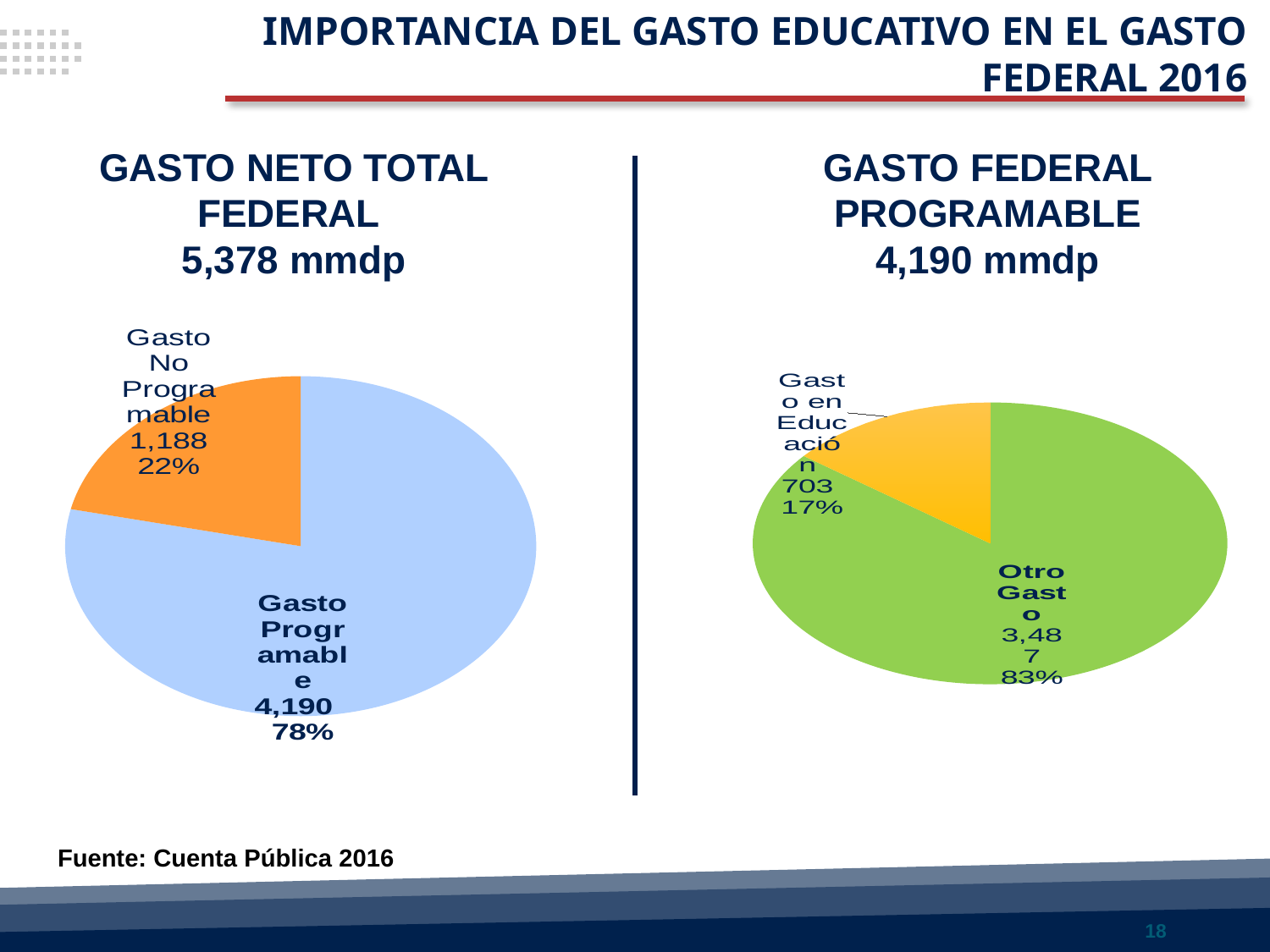
What kind of chart is the 'GASTO NETO TOTAL FEDERAL' chart? Pie chart In the 'GASTO FEDERAL PROGRAMABLE' chart, what share of the pie is Otro Gasto? 83% In the 'GASTO NETO TOTAL FEDERAL' chart, which slice is the largest? Gasto Programable In the 'GASTO NETO TOTAL FEDERAL' chart, what share of the pie is Gasto No Programable? 22% In the 'GASTO FEDERAL PROGRAMABLE' chart, what is the difference between Otro Gasto and Gasto en Educación? 2,784 In the 'GASTO NETO TOTAL FEDERAL' chart, what is the value for Gasto Programable? 4,190 In the 'GASTO FEDERAL PROGRAMABLE' chart, what is the value for Gasto en Educación? 703 In the 'GASTO FEDERAL PROGRAMABLE' chart, which slice is the smallest? Gasto en Educación In the 'GASTO NETO TOTAL FEDERAL' chart, what is the value for Gasto No Programable? 1,188 In the 'GASTO NETO TOTAL FEDERAL' chart, what is the difference between Gasto Programable and Gasto No Programable? 3,002 In the 'GASTO FEDERAL PROGRAMABLE' chart, what colour is the Otro Gasto slice? Green How many slices does the 'GASTO FEDERAL PROGRAMABLE' chart have? 2